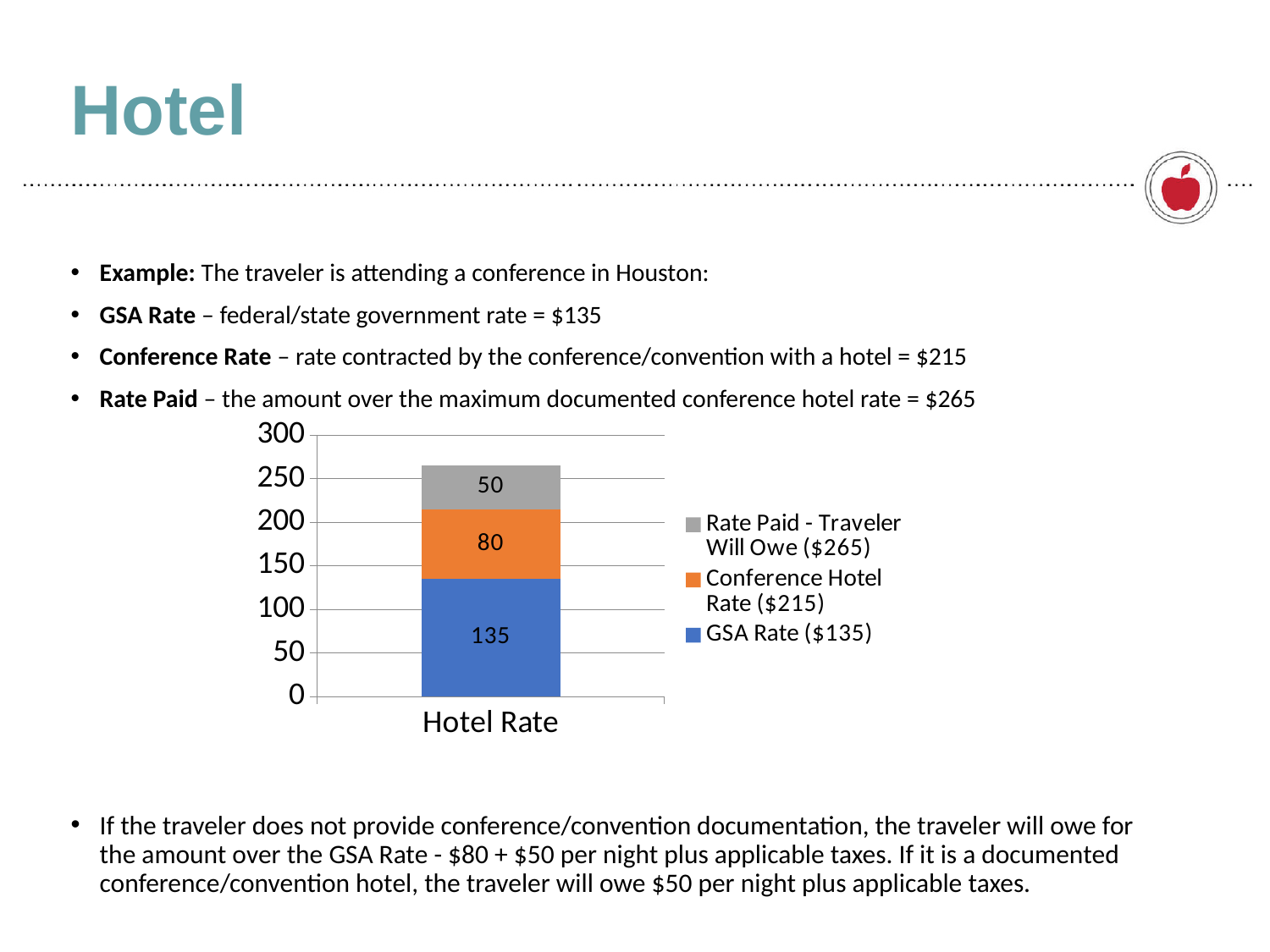
What colour is the GSA Rate ($135) segment? blue What is the value of the Conference Hotel Rate ($215) segment in the Hotel Rate bar? 80 What is the difference between the GSA Rate segment and the Conference Hotel Rate segment? 55 Which is larger, the Conference Hotel Rate segment or the Rate Paid - Traveler Will Owe segment? Conference Hotel Rate ($215) What kind of chart is shown on the slide? stacked bar chart Which segment of the Hotel Rate bar is the smallest? Rate Paid - Traveler Will Owe ($265) What is the value of the Rate Paid - Traveler Will Owe ($265) segment in the Hotel Rate bar? 50 How many series does the legend list? 3 What is the total of the stacked Hotel Rate bar? 265 Which segment of the Hotel Rate bar is the largest? GSA Rate ($135) What is the value of the GSA Rate ($135) segment in the Hotel Rate bar? 135 How many categories are shown on the x axis? 1